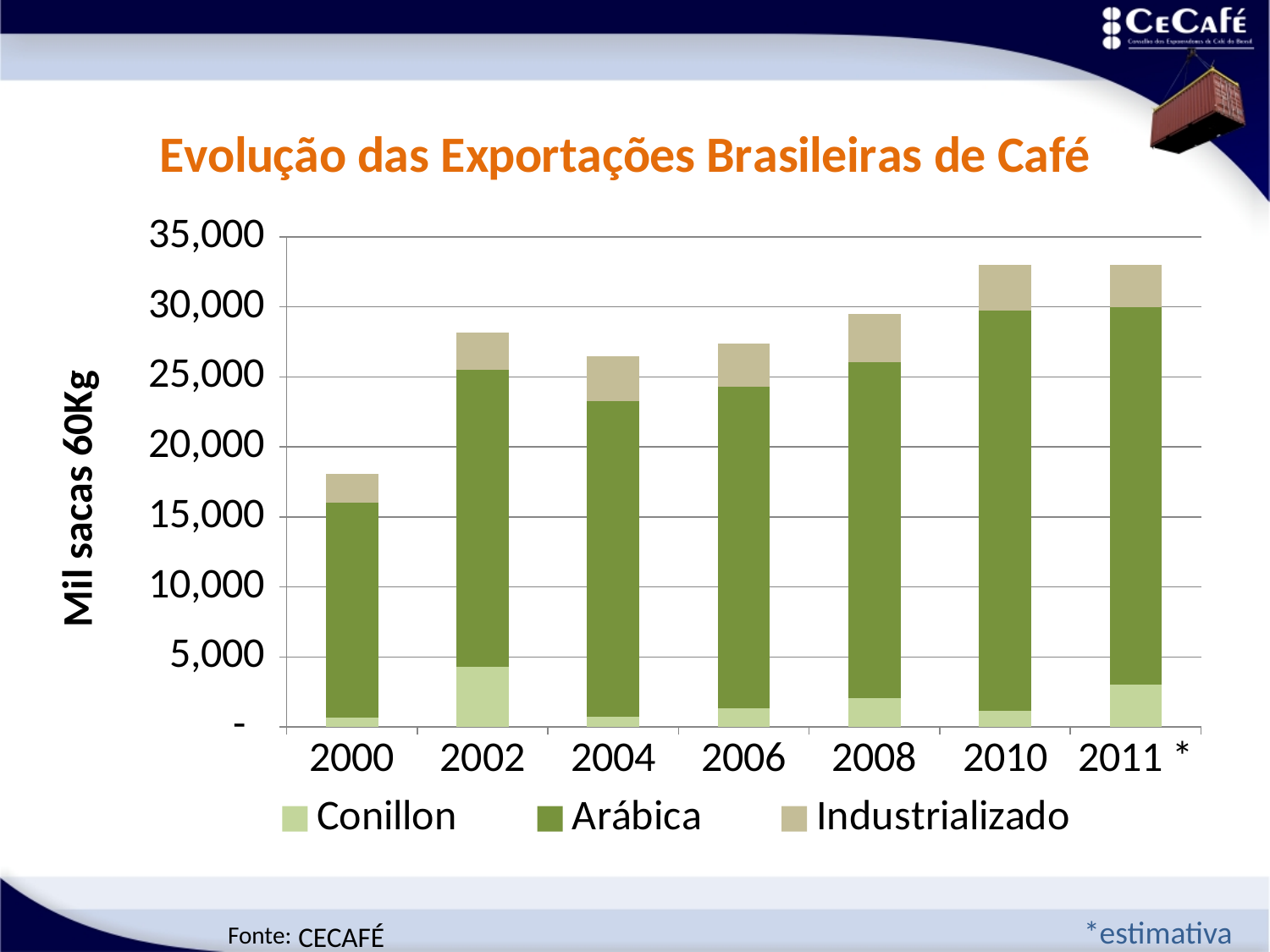
Which year has the lowest total exports in the chart? 2000 Is the total bar for 2010 greater or less than 30,000? greater What kind of chart is shown on the slide? Stacked bar chart How many years (categories) are shown on the x axis of the chart? 7 Is the total bar for 2000 greater or less than 20,000? less Is the total bar for 2002 greater or less than 25,000? greater What is the label of the vertical axis of the chart? Mil sacas 60Kg What is the title of the chart on the slide? Evolução das Exportações Brasileiras de Café Which year has the larger total exports, 2000 or 2011*? 2011* How many series does the chart legend list? 3